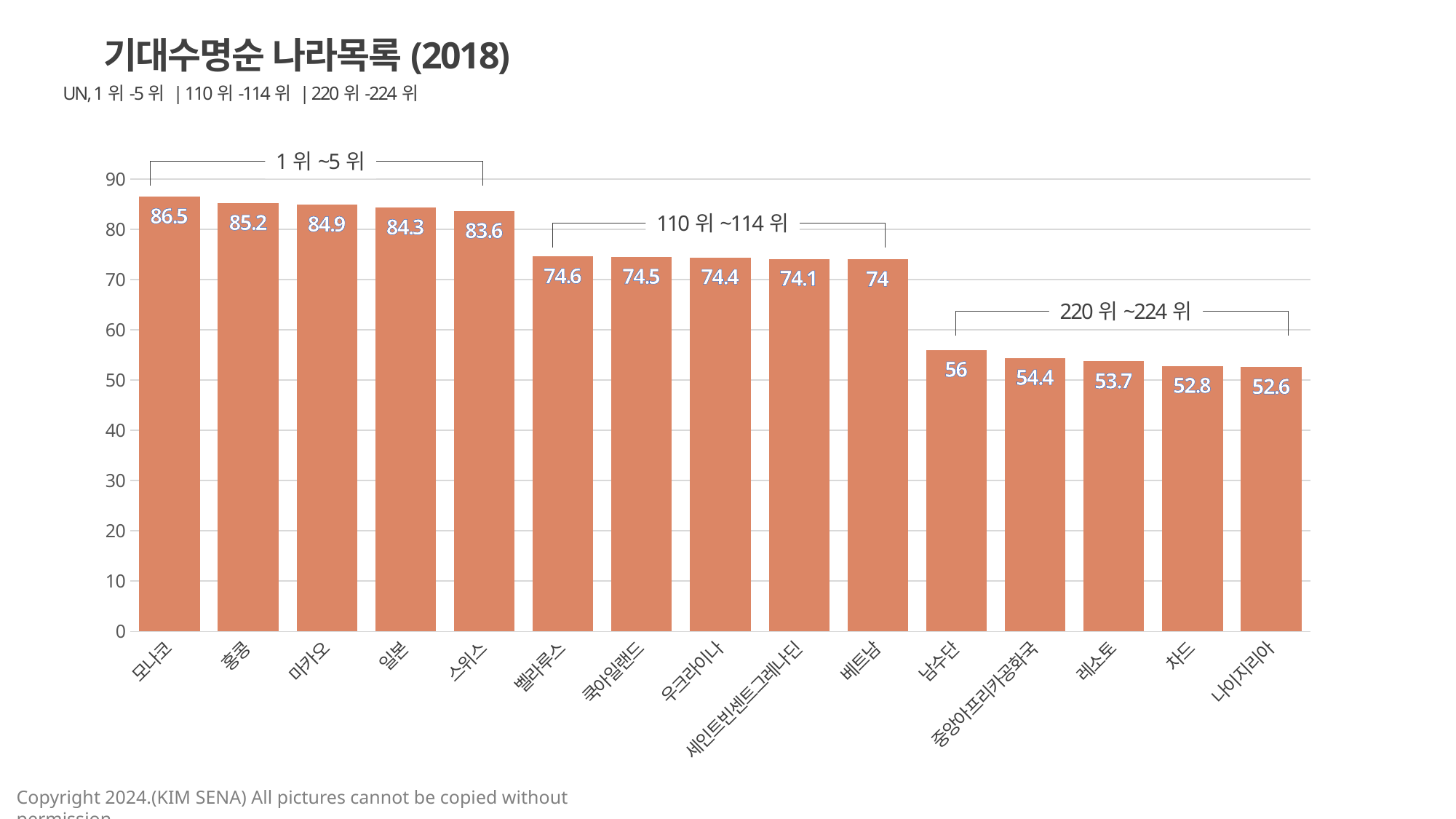
Which country has the highest value? 모나코 What is the difference between the values for 모나코 and 나이지리아? 33.9 What is the title of the chart? 기대수명순 나라목록 (2018) Which is larger, the value for 홍콩 or the value for 벨라루스? 홍콩 Which country has the lowest value? 나이지리아 What is the difference between the values for 일본 and 스위스? 0.7 Is the value for 남수단 greater or less than 60? less What kind of chart is shown on the slide? bar chart What is the value for 중앙아프리카공화국? 54.4 What is the value for 베트남? 74 How many countries are shown in the chart? 15 What is the value for 모나코? 86.5